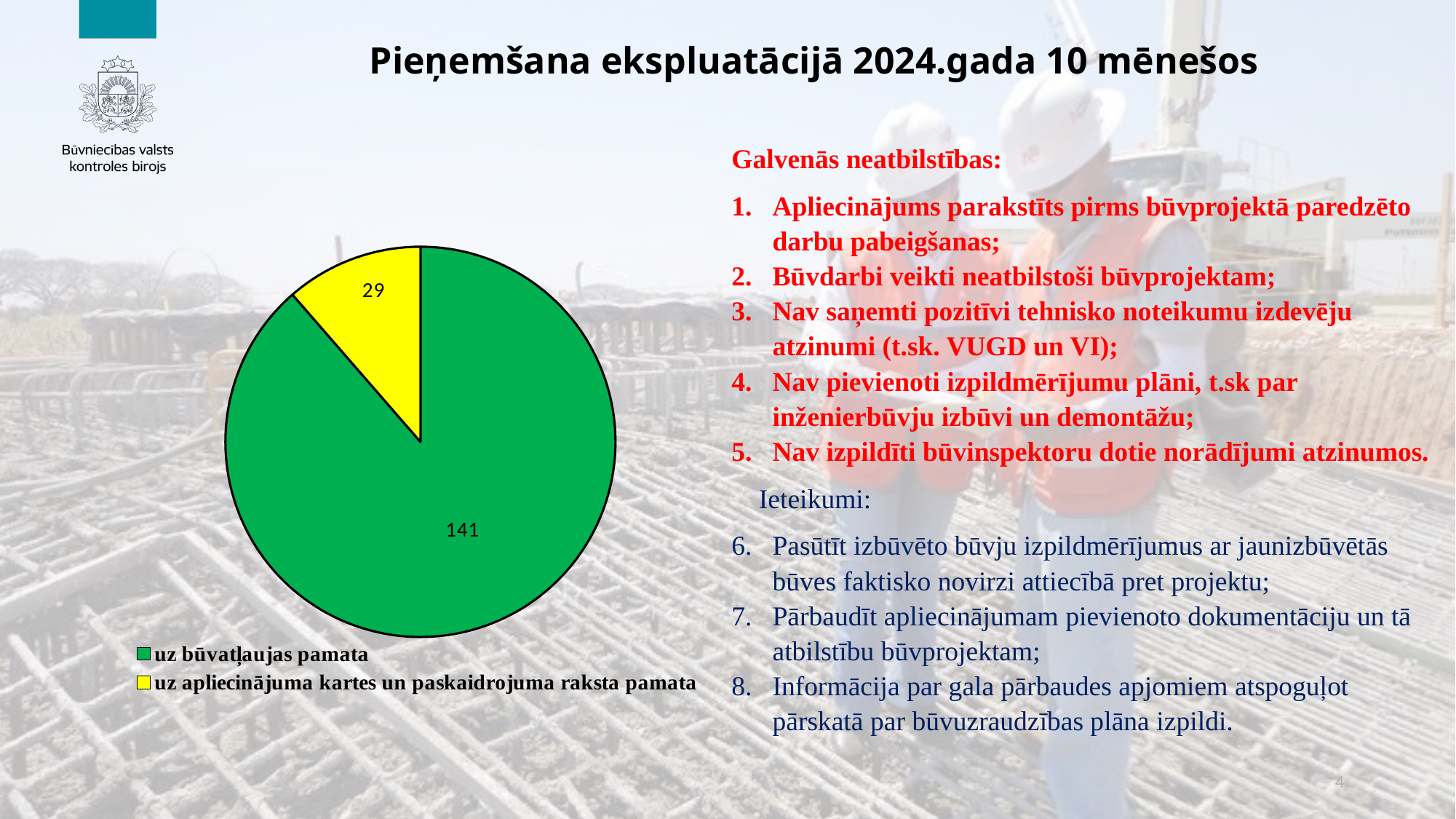
Which category has the smallest slice of the pie? uz apliecinājuma kartes un paskaidrojuma raksta pamata What is the total of all slices in the pie chart? 170 Which category has the largest slice of the pie? uz būvatļaujas pamata What type of chart is shown on the slide? pie chart What is the value for "uz apliecinājuma kartes un paskaidrojuma raksta pamata"? 29 What colour is the slice for "uz apliecinājuma kartes un paskaidrojuma raksta pamata"? yellow Which is larger: the value for "uz būvatļaujas pamata" or the value for "uz apliecinājuma kartes un paskaidrojuma raksta pamata"? uz būvatļaujas pamata What is the difference between the value for "uz būvatļaujas pamata" and the value for "uz apliecinājuma kartes un paskaidrojuma raksta pamata"? 112 What is the value for "uz būvatļaujas pamata"? 141 How many slices does the pie chart have? 2 How many entries does the chart legend list? 2